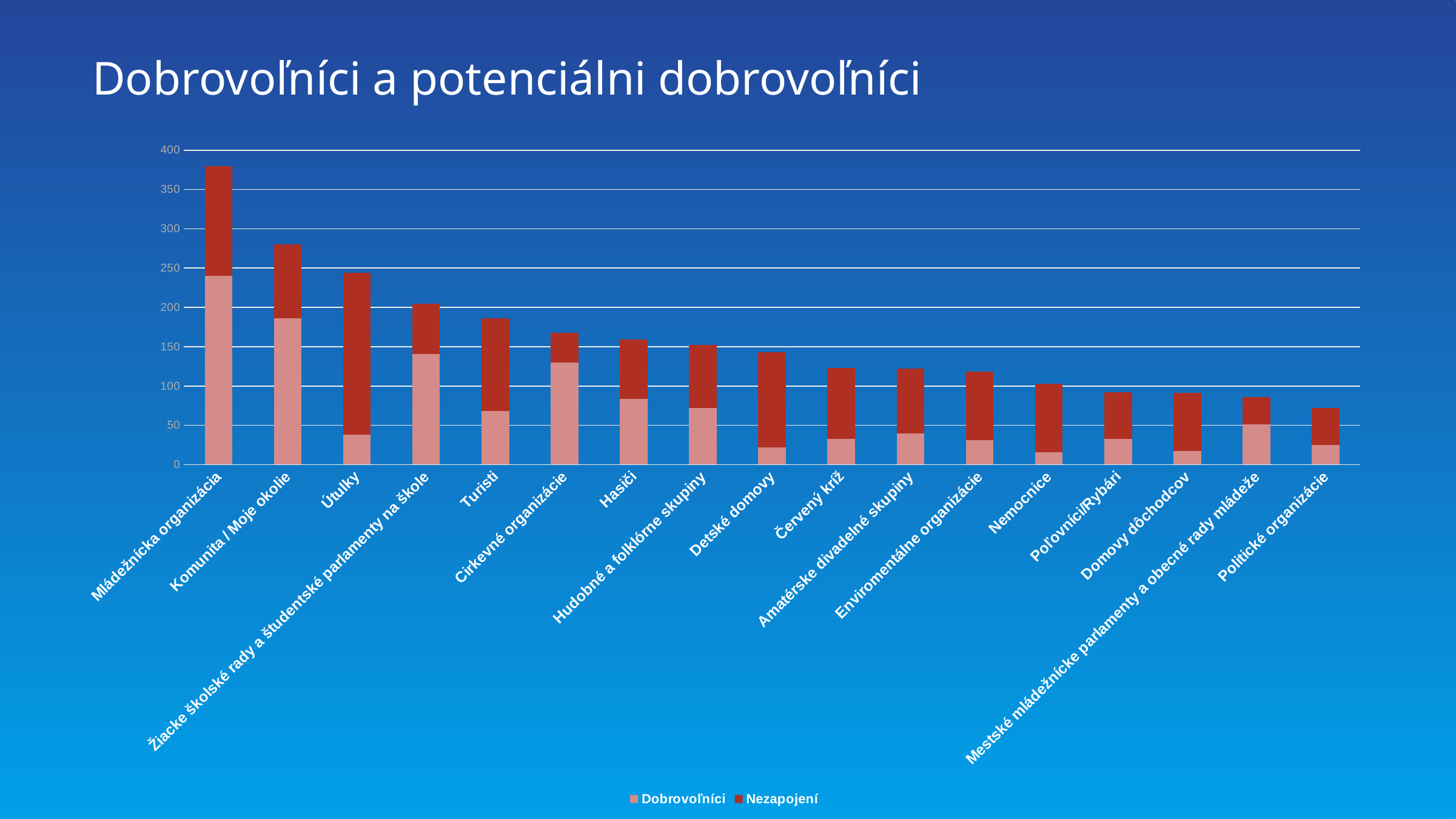
How many categories are shown on the x axis of the chart? 17 What kind of chart is shown on the slide? Stacked bar chart What are the two series named in the legend? Dobrovoľníci and Nezapojení What is the title of the slide? Dobrovoľníci a potenciálni dobrovoľníci Is the Dobrovoľníci value for Útulky greater or less than 50? less Which has the larger total bar, Komunita / Moje okolie or Útulky? Komunita / Moje okolie Which category has the highest total bar? Mládežnícka organizácia Is the total bar for Mládežnícka organizácia greater or less than 350? greater Is the total bar for Politické organizácie greater or less than 100? less Do the total bar heights rise or fall moving from left to right along the x axis? fall How many series does the chart's legend list? 2 Which category has the lowest total bar? Politické organizácie